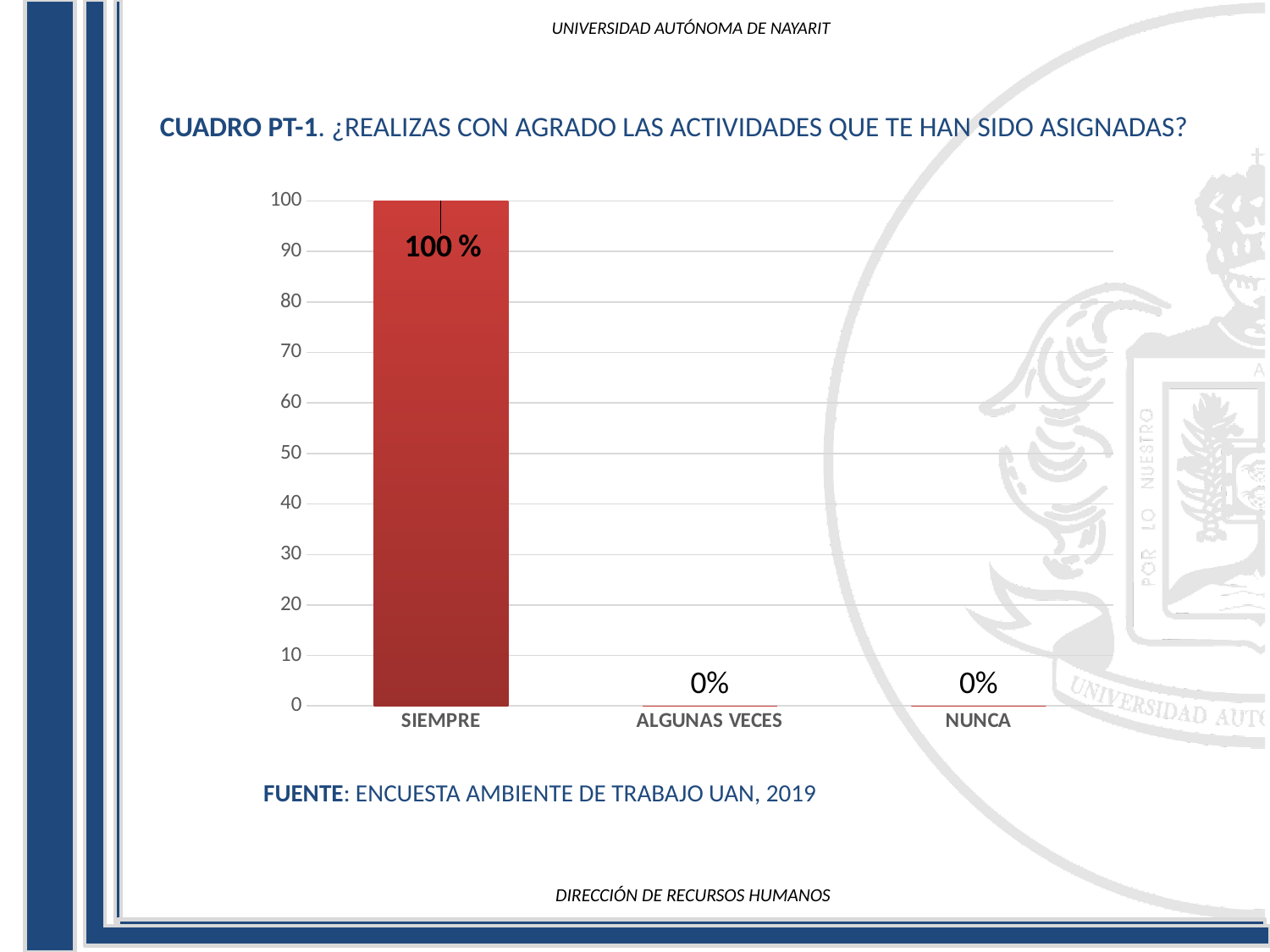
What is the highest value shown on the y axis? 100 What is the value for NUNCA? 0% What source is cited below the chart? ENCUESTA AMBIENTE DE TRABAJO UAN, 2019 How many categories are shown on the x axis? 3 Which is larger, the value for SIEMPRE or the value for ALGUNAS VECES? SIEMPRE What kind of chart is shown on the slide? bar chart Which category has the highest value? SIEMPRE Do the values rise or fall from SIEMPRE to NUNCA along the x axis? fall What is the difference between the values for SIEMPRE and NUNCA? 100 Is the value for SIEMPRE greater or less than 50? greater What is the value for SIEMPRE? 100 % What is the value for ALGUNAS VECES? 0%